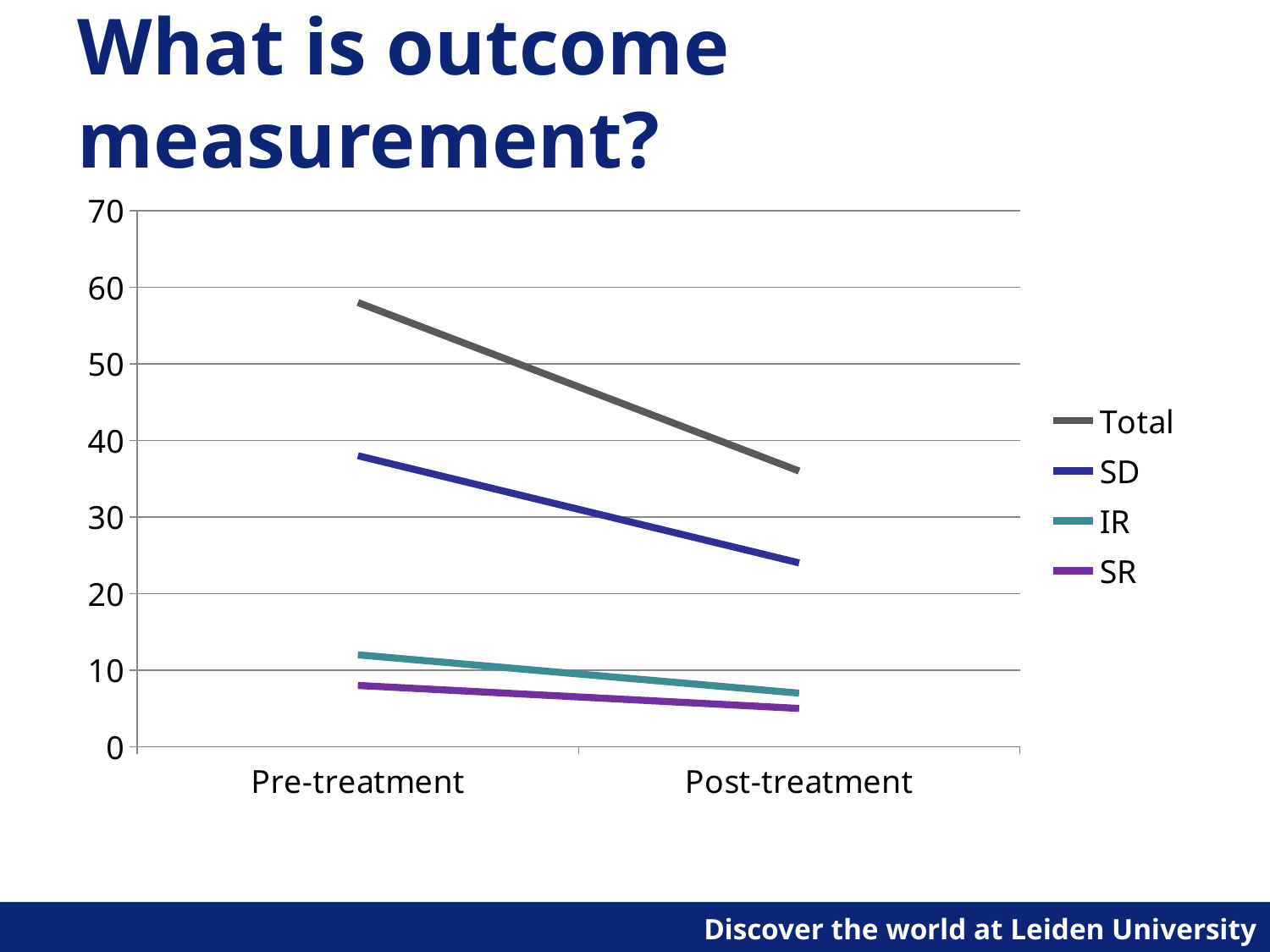
How many series does the legend list? 4 At Post-treatment, which is larger: SD or IR? SD Is the value for Total at Pre-treatment greater or less than 50? greater Does the Total series rise or fall from Pre-treatment to Post-treatment? fall Is the value for SD at Post-treatment greater or less than 20? greater Is the value for SR at Post-treatment greater or less than 10? less Which series has the lowest value at Post-treatment? SR How many categories are shown on the x axis? 2 What kind of chart is shown on the slide? line chart What is the title of the slide containing the chart? What is outcome measurement? Which series has the highest value at Pre-treatment? Total